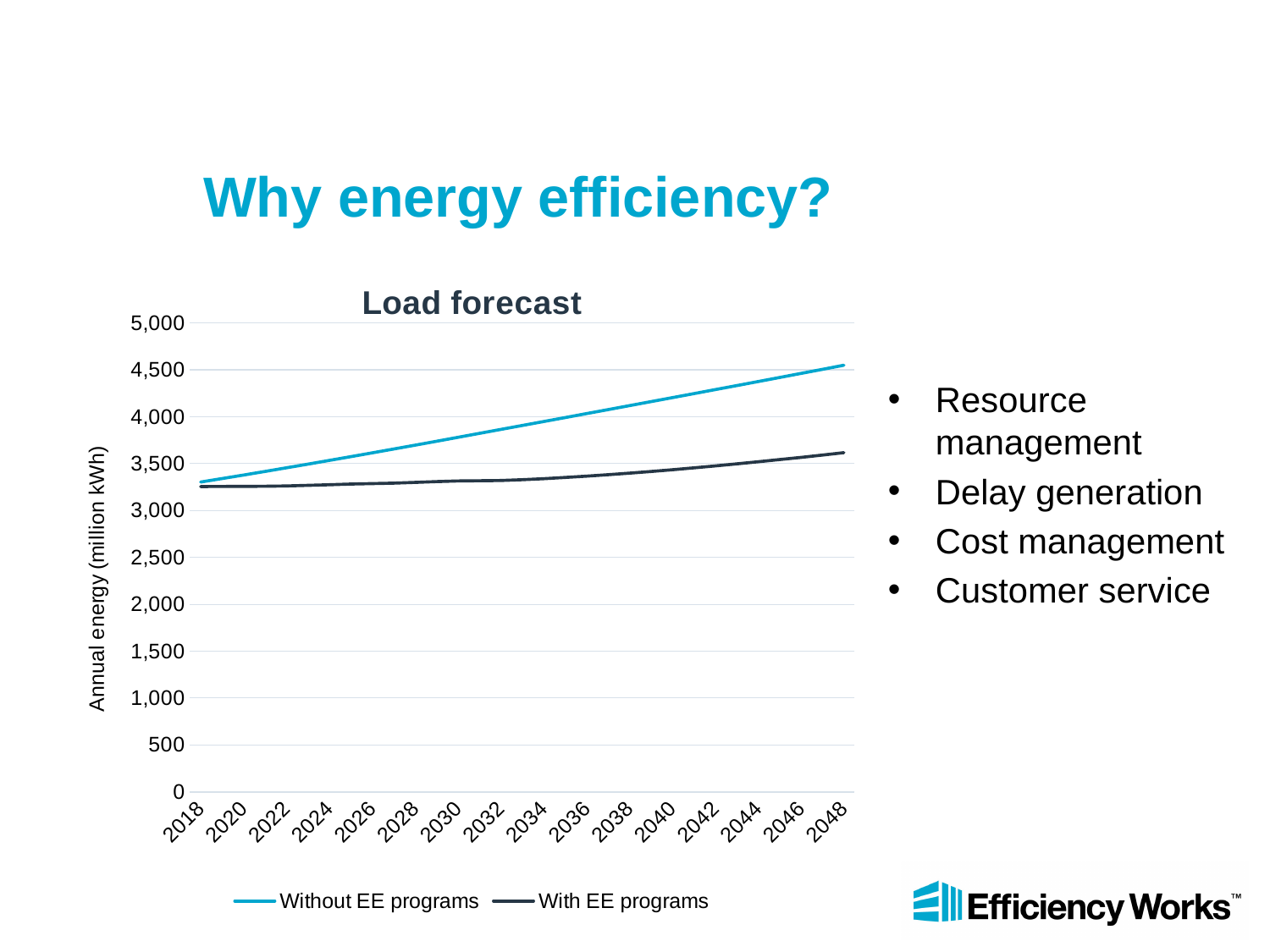
In 2048, which series is higher: Without EE programs or With EE programs? Without EE programs What is the title of the chart on the slide? Load forecast Is the value for Without EE programs in 2018 greater or less than 3,500? less How many year labels are shown along the x axis of the Load forecast chart? 16 Does the Without EE programs line rise or fall from 2018 to 2048? rise What kind of chart is the Load forecast chart? line chart Is the value for With EE programs in 2048 greater or less than 4,000? less Is the value for Without EE programs in 2048 greater or less than 4,000? greater What is the label of the vertical axis on the Load forecast chart? Annual energy (million kWh) How many series does the legend of the Load forecast chart list? 2 Does the With EE programs line rise or fall from 2018 to 2048? rise